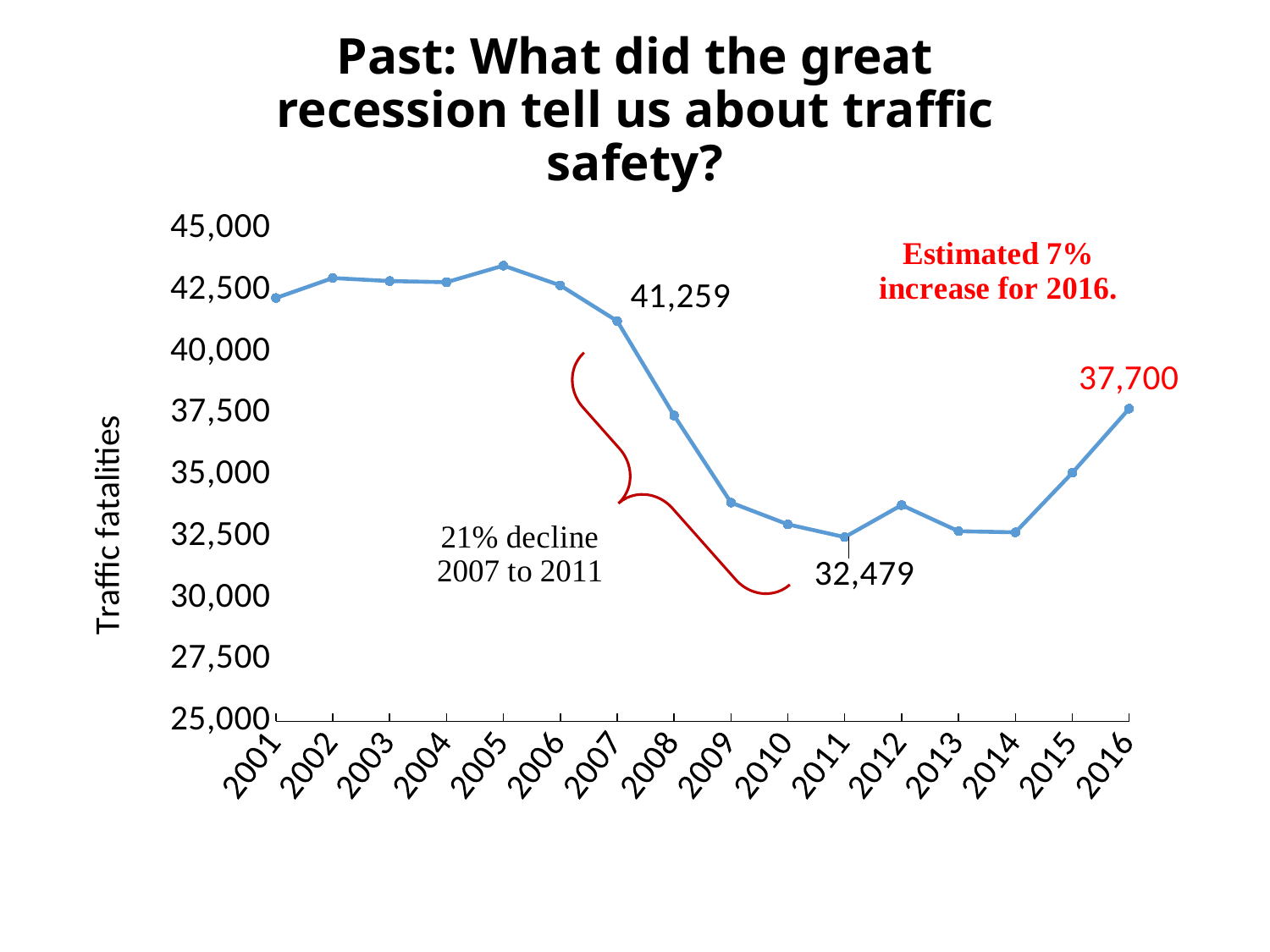
Is the value for 2001 greater or less than 40,000? greater What kind of chart is shown on the slide? line chart Do the values rise or fall from 2007 to 2011? fall What is the value for 2007? 41,259 Which year has the highest value on the chart? 2005 What is the value for 2011? 32,479 What is the difference between the 2007 value and the 2011 value? 8,780 How many years are shown on the x axis? 16 Which is larger, the value for 2007 or the value for 2016? 2007 What is the value for 2016? 37,700 Is the value for 2015 greater or less than 37,500? less What is the difference between the 2016 value and the 2011 value? 5,221